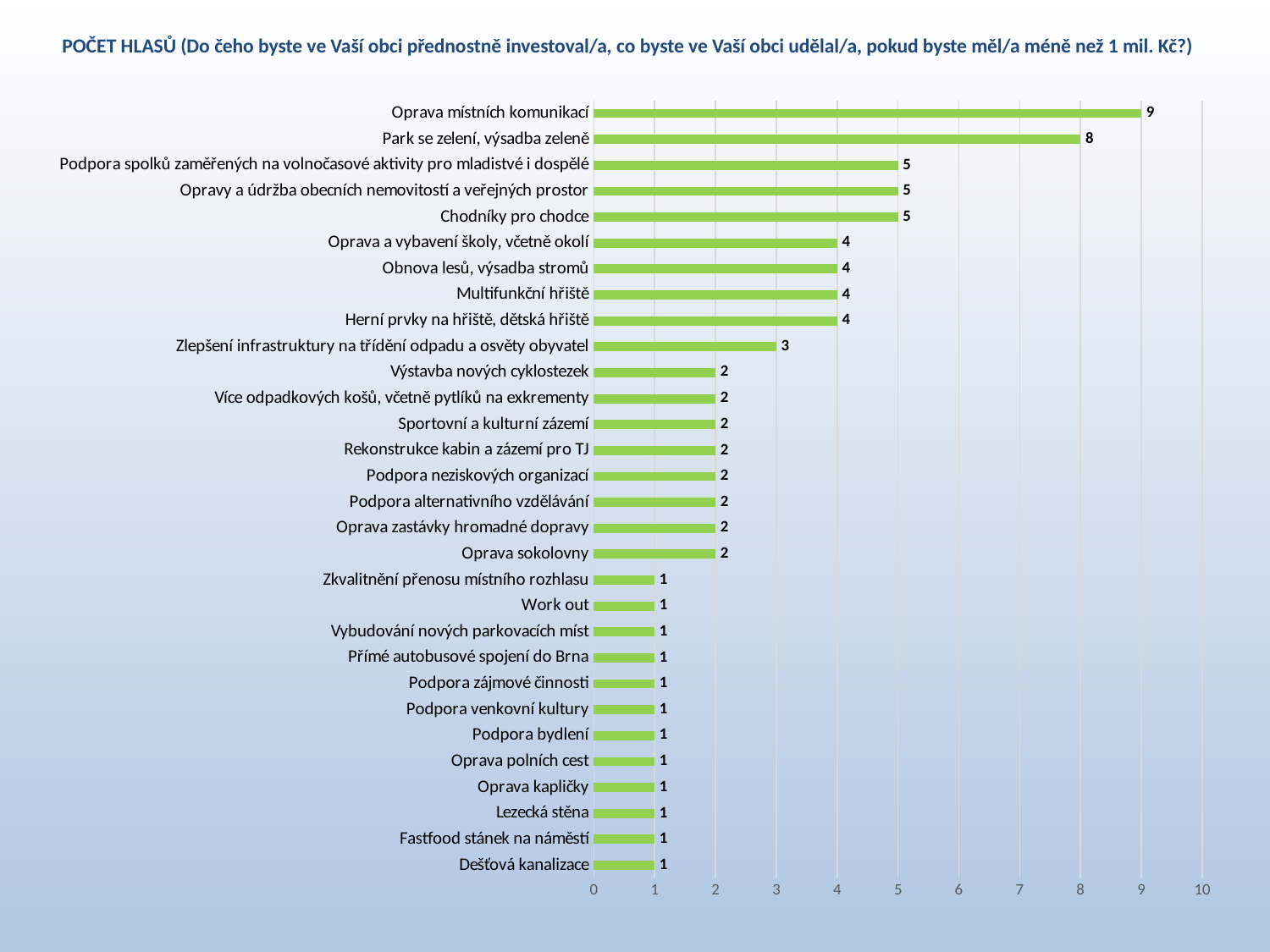
How many votes did "Oprava místních komunikací" receive? 9 What is the difference between the values for "Oprava místních komunikací" and "Park se zelení, výsadba zeleně"? 1 Which category has the highest number of votes? Oprava místních komunikací What is the highest value shown on the horizontal axis? 10 What is the value for "Chodníky pro chodce"? 5 What kind of chart is shown on the slide? Bar chart What is the value for "Park se zelení, výsadba zeleně"? 8 What is the value for "Zlepšení infrastruktury na třídění odpadu a osvěty obyvatel"? 3 Which has a larger value, "Multifunkční hřiště" or "Výstavba nových cyklostezek"? Multifunkční hřiště Which has a larger value, "Work out" or "Obnova lesů, výsadba stromů"? Obnova lesů, výsadba stromů What is the difference between the values for "Chodníky pro chodce" and "Oprava sokolovny"? 3 How many categories are shown in the chart? 30